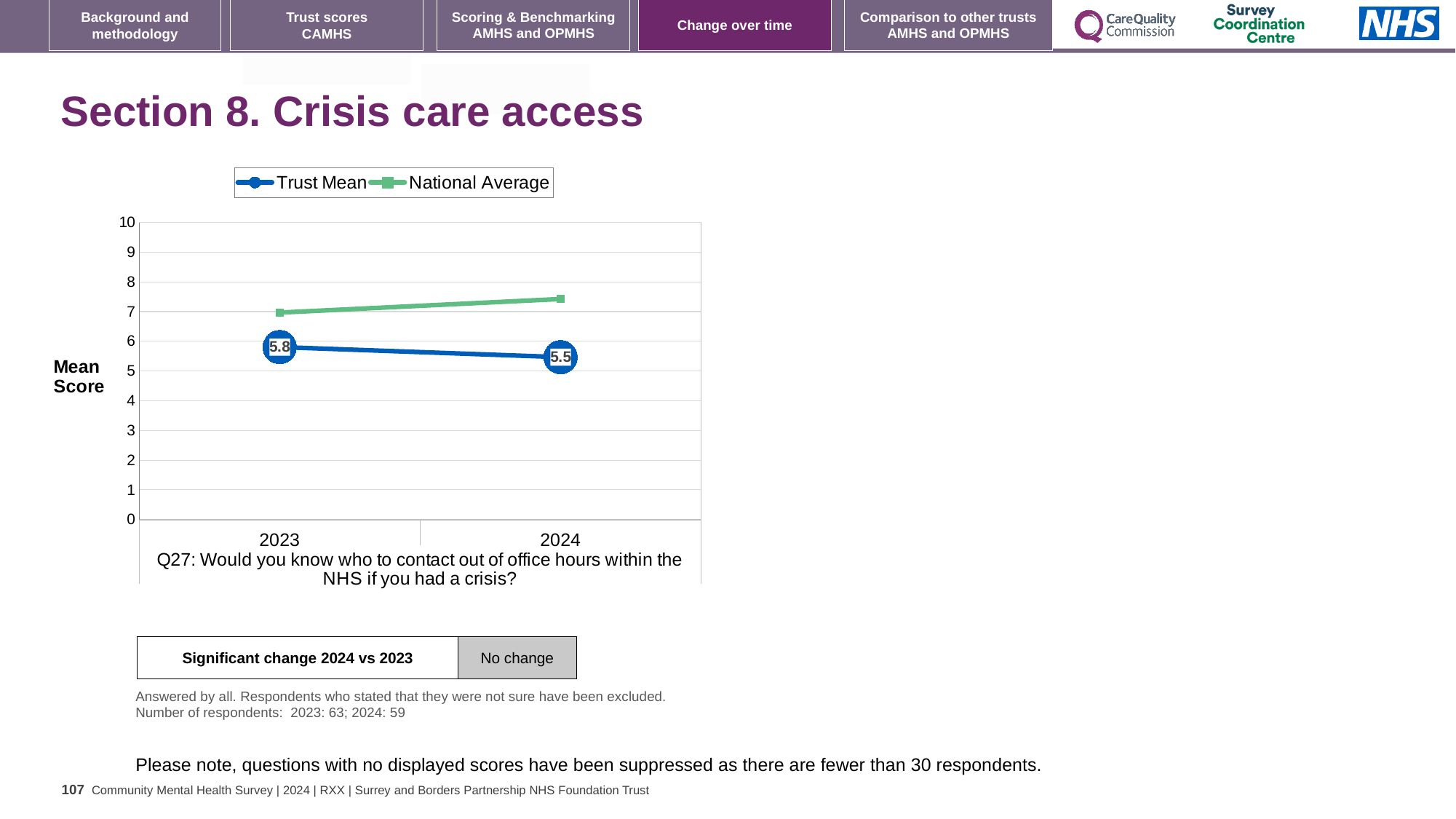
What is the Trust Mean score for 2023? 5.8 How many series does the legend list? 2 How many years are shown on the x axis? 2 What is the difference between the Trust Mean in 2023 and 2024? 0.3 What is the Trust Mean score for 2024? 5.5 Does the Trust Mean rise or fall from 2023 to 2024? fall In 2024, which is higher: the Trust Mean or the National Average? National Average Is the National Average for 2023 greater or less than 6? greater Does the National Average rise or fall from 2023 to 2024? rise Which year has the higher Trust Mean score? 2023 Is the National Average for 2024 greater or less than 7? greater What type of chart is shown on the slide? line chart